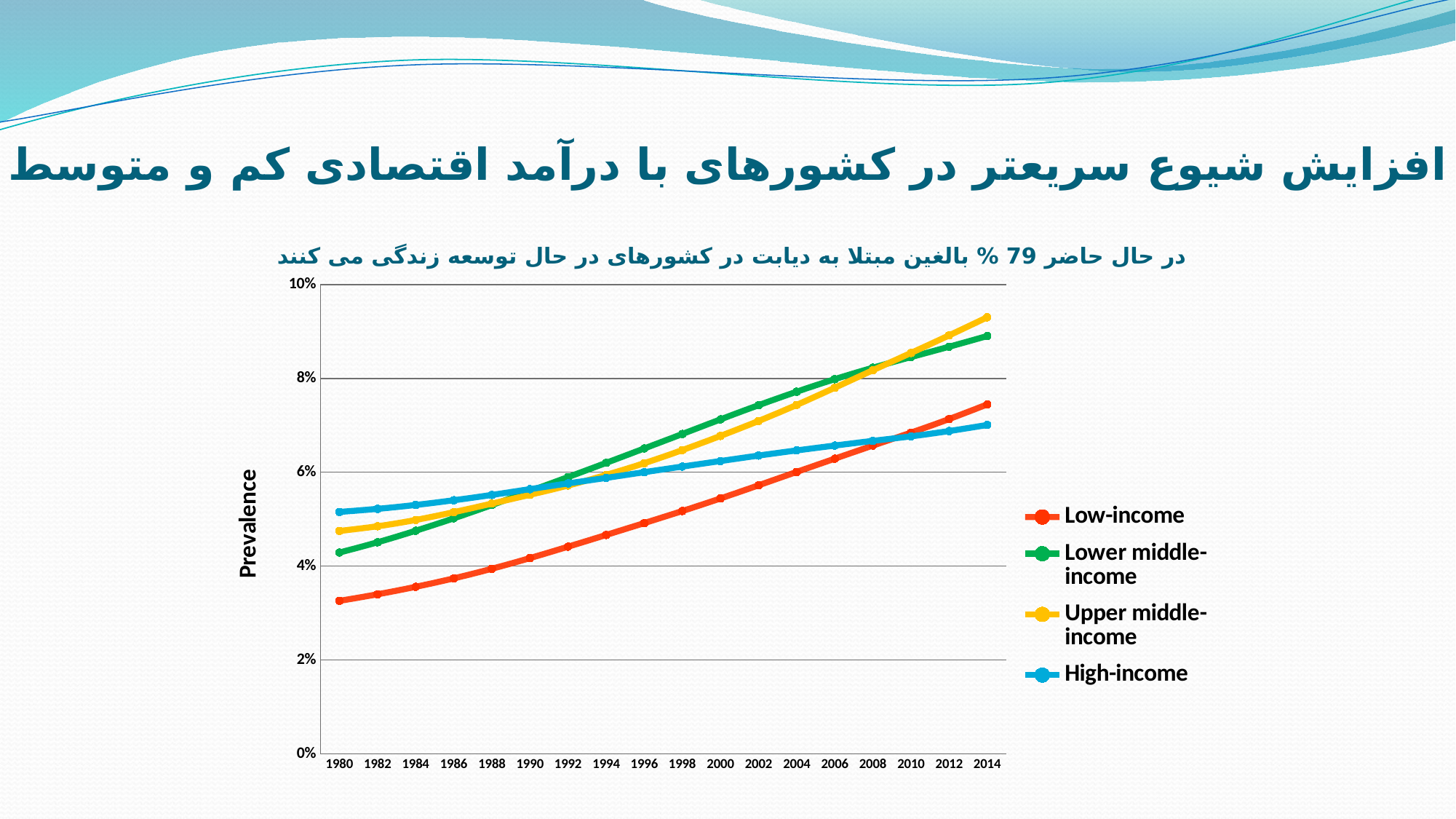
Which series has the highest value in 2014? Upper middle-income Is the value for Low-income in 1980 greater or less than 4%? less Which series has the lowest value in 1980? Low-income What colour is the Low-income line? red What kind of chart is shown on the slide? line chart How many series does the legend list? 4 How many years are marked along the x axis? 18 What is the title of the y axis? Prevalence Does the Low-income series rise or fall from 1980 to 2014? rise Is the value for Upper middle-income in 2014 greater or less than 8%? greater In 2014, which is larger: the Upper middle-income value or the High-income value? Upper middle-income Which series has the highest value in 1980? High-income